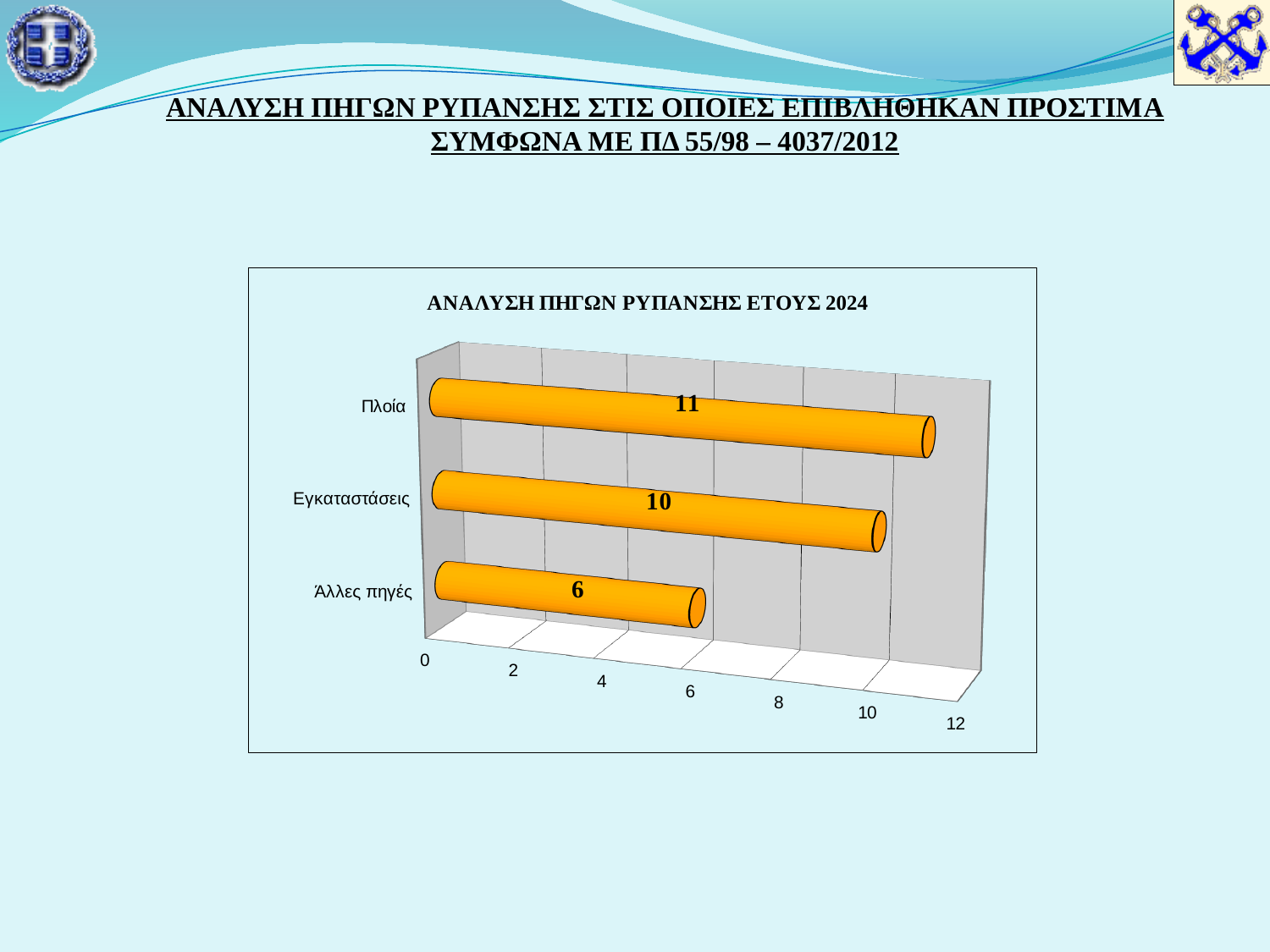
Is the value for Πλοία greater or less than 8? greater How many categories are shown in the chart? 3 What kind of chart is shown on the slide? bar chart What is the value for Εγκαταστάσεις? 10 What is the title of the chart? ΑΝΑΛΥΣΗ ΠΗΓΩΝ ΡΥΠΑΝΣΗΣ ΕΤΟΥΣ 2024 Which is larger, the value for Εγκαταστάσεις or the value for Άλλες πηγές? Εγκαταστάσεις Which category has the lowest value? Άλλες πηγές What is the value for Πλοία? 11 What is the difference between the values for Εγκαταστάσεις and Άλλες πηγές? 4 What is the difference between the values for Πλοία and Άλλες πηγές? 5 Which category has the highest value? Πλοία What is the value for Άλλες πηγές? 6